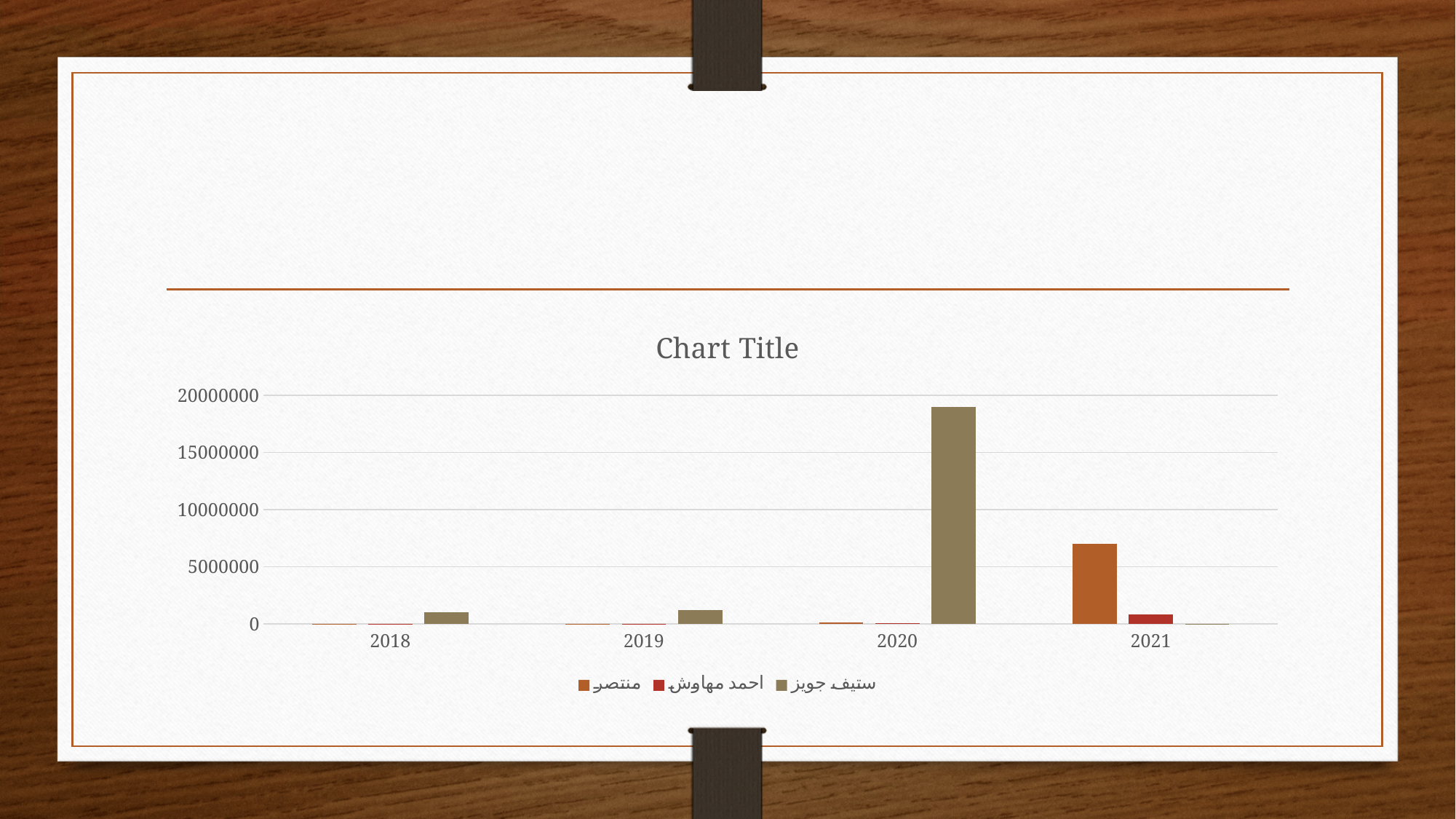
What kind of chart is shown on the slide? bar chart How many years are shown on the x axis of the chart? 4 In 2021, which series has the larger value, منتصر or احمد مهاوش? منتصر Is the value for ستيف جوبز in 2020 greater or less than 15000000? greater Is the value for ستيف جوبز in 2018 greater or less than 5000000? less How many series does the chart legend list? 3 Which is larger: the value for ستيف جوبز in 2020 or the value for منتصر in 2021? ستيف جويز in 2020 Is the value for منتصر in 2021 greater or less than 10000000? less What is the title of the chart? Chart Title Which series has the tallest bar in the chart? ستيف جويز In which year does the chart show its tallest bar? 2020